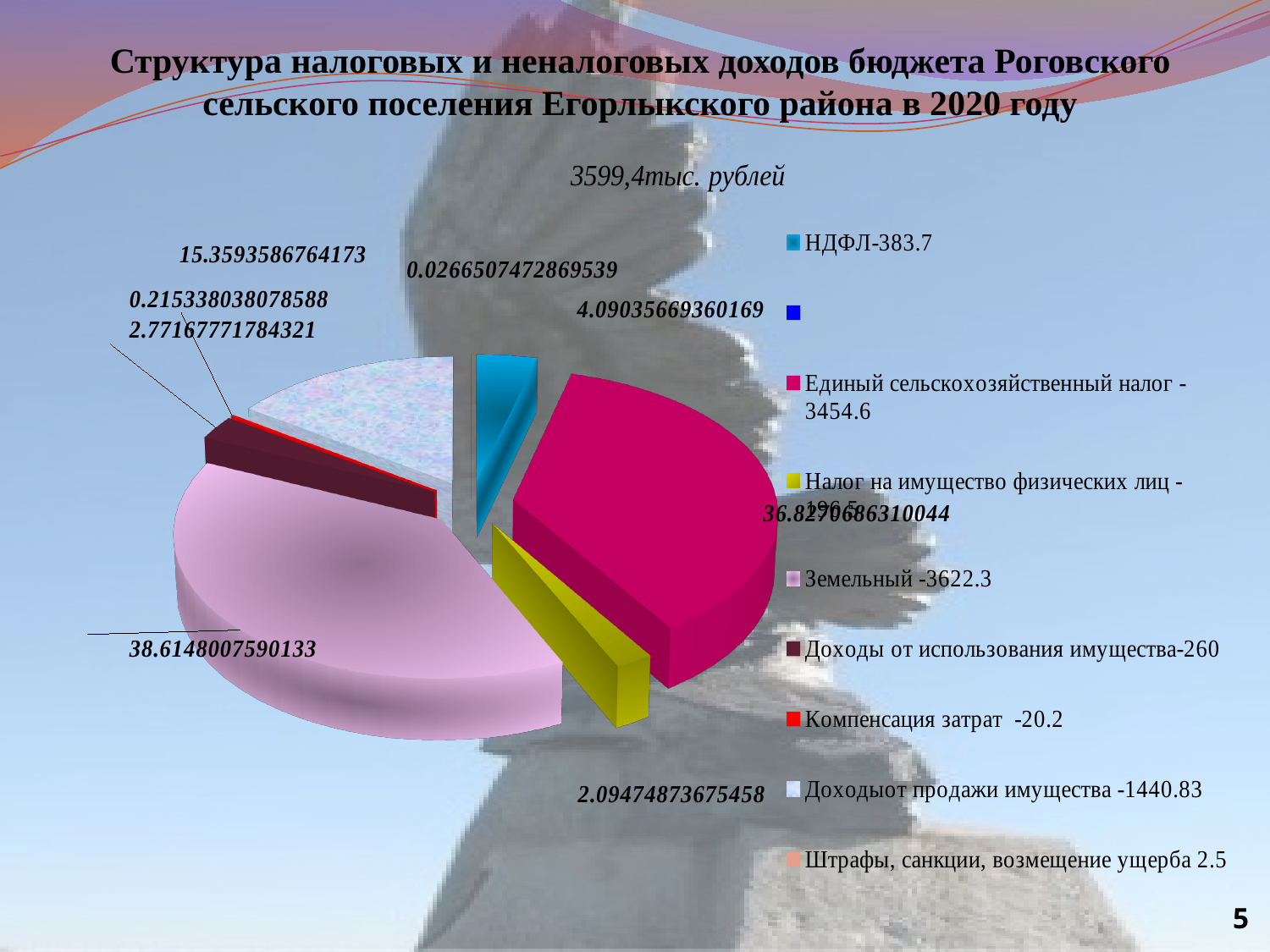
What value does the legend give for Земельный? 3622.3 What value does the legend give for НДФЛ? 383.7 Which is larger according to the legend: Земельный or Единый сельскохозяйственный налог? Земельный What value does the legend give for Компенсация затрат? 20.2 What total amount is printed under the chart title? 3599,4тыс. рублей What value does the legend give for Доходы от использования имущества? 260 What value does the legend give for Доходы от продажи имущества? 1440.83 What value does the legend give for Единый сельскохозяйственный налог? 3454.6 What kind of chart is shown on the slide? pie chart What is the difference between the legend values for Земельный and Единый сельскохозяйственный налог? 167.7 Which legend category has the largest value? Земельный Which legend category has the smallest value? Штрафы, санкции, возмещение ущерба